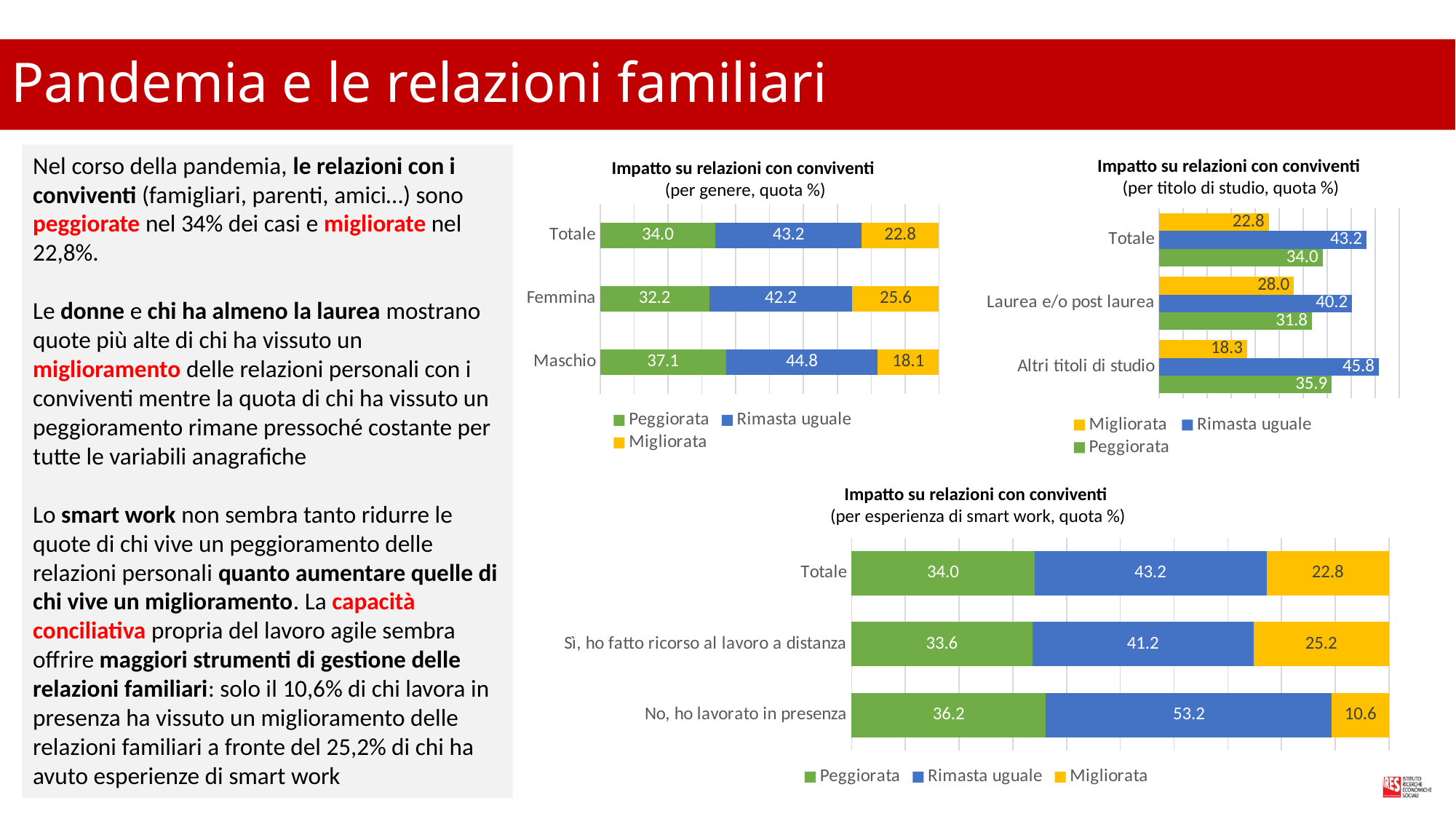
In the chart 'Impatto su relazioni con conviventi (per esperienza di smart work, quota %)', what is the Migliorata value for 'No, ho lavorato in presenza'? 10.6 What kind of chart is 'Impatto su relazioni con conviventi (per esperienza di smart work, quota %)'? Stacked bar chart In the chart 'Impatto su relazioni con conviventi (per esperienza di smart work, quota %)', what is the difference between the Migliorata values for 'Sì, ho fatto ricorso al lavoro a distanza' and 'No, ho lavorato in presenza'? 14.6 In the chart 'Impatto su relazioni con conviventi (per genere, quota %)', what is the total of the stacked bar for Maschio? 100.0 In the chart 'Impatto su relazioni con conviventi (per genere, quota %)', which category has the highest Peggiorata value? Maschio In the chart 'Impatto su relazioni con conviventi (per genere, quota %)', what is the Migliorata value for Femmina? 25.6 In the chart 'Impatto su relazioni con conviventi (per titolo di studio, quota %)', which category has the lowest Migliorata value? Altri titoli di studio In the chart 'Impatto su relazioni con conviventi (per titolo di studio, quota %)', what is the Migliorata value for Laurea e/o post laurea? 28.0 In the chart 'Impatto su relazioni con conviventi (per genere, quota %)', what is the difference between the Rimasta uguale values for Maschio and Femmina? 2.6 In the chart 'Impatto su relazioni con conviventi (per titolo di studio, quota %)', is the Rimasta uguale value larger for Laurea e/o post laurea or for Altri titoli di studio? Altri titoli di studio In the chart 'Impatto su relazioni con conviventi (per esperienza di smart work, quota %)', how many categories are shown? 3 In the chart 'Impatto su relazioni con conviventi (per titolo di studio, quota %)', how many series does the legend list? 3